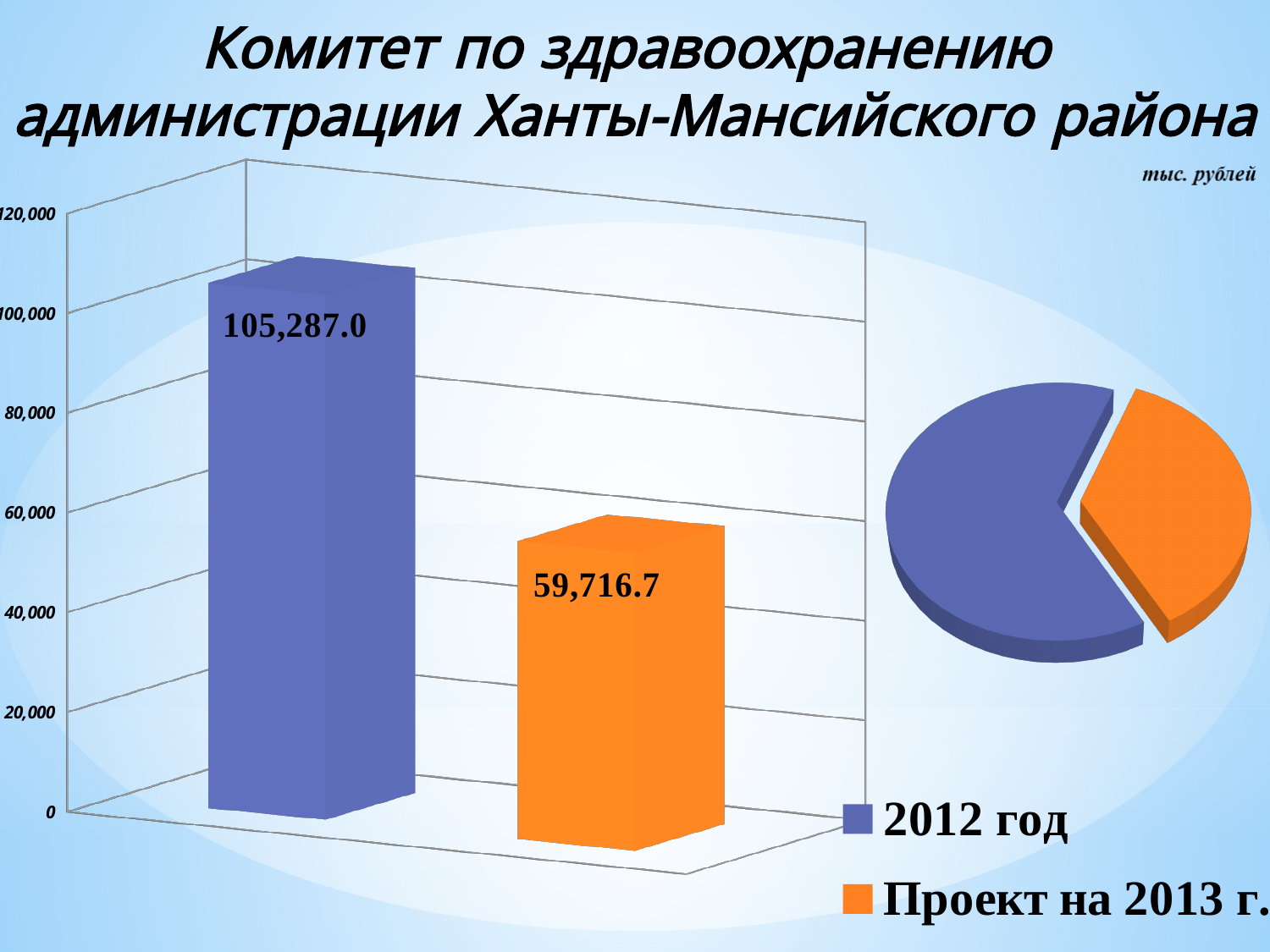
In the bar chart, what is the difference between the value for 2012 год and the value for Проект на 2013 г.? 45,570.3 In the bar chart, what is the value for Проект на 2013 г.? 59,716.7 What unit is indicated above the bar chart? тыс. рублей How many bars are shown in the bar chart on the left? 2 In the bar chart, is the value for Проект на 2013 г. greater or less than 80,000? less In the bar chart, is the value for 2012 год greater or less than 100,000? greater In the bar chart, what is the value for 2012 год? 105,287.0 What kind of chart is the chart on the right side of the slide? pie chart In the bar chart, which category has the lowest value? Проект на 2013 г. In the bar chart, which is larger: the value for 2012 год or the value for Проект на 2013 г.? 2012 год How many entries does the legend list? 2 In the bar chart, which category has the highest value? 2012 год